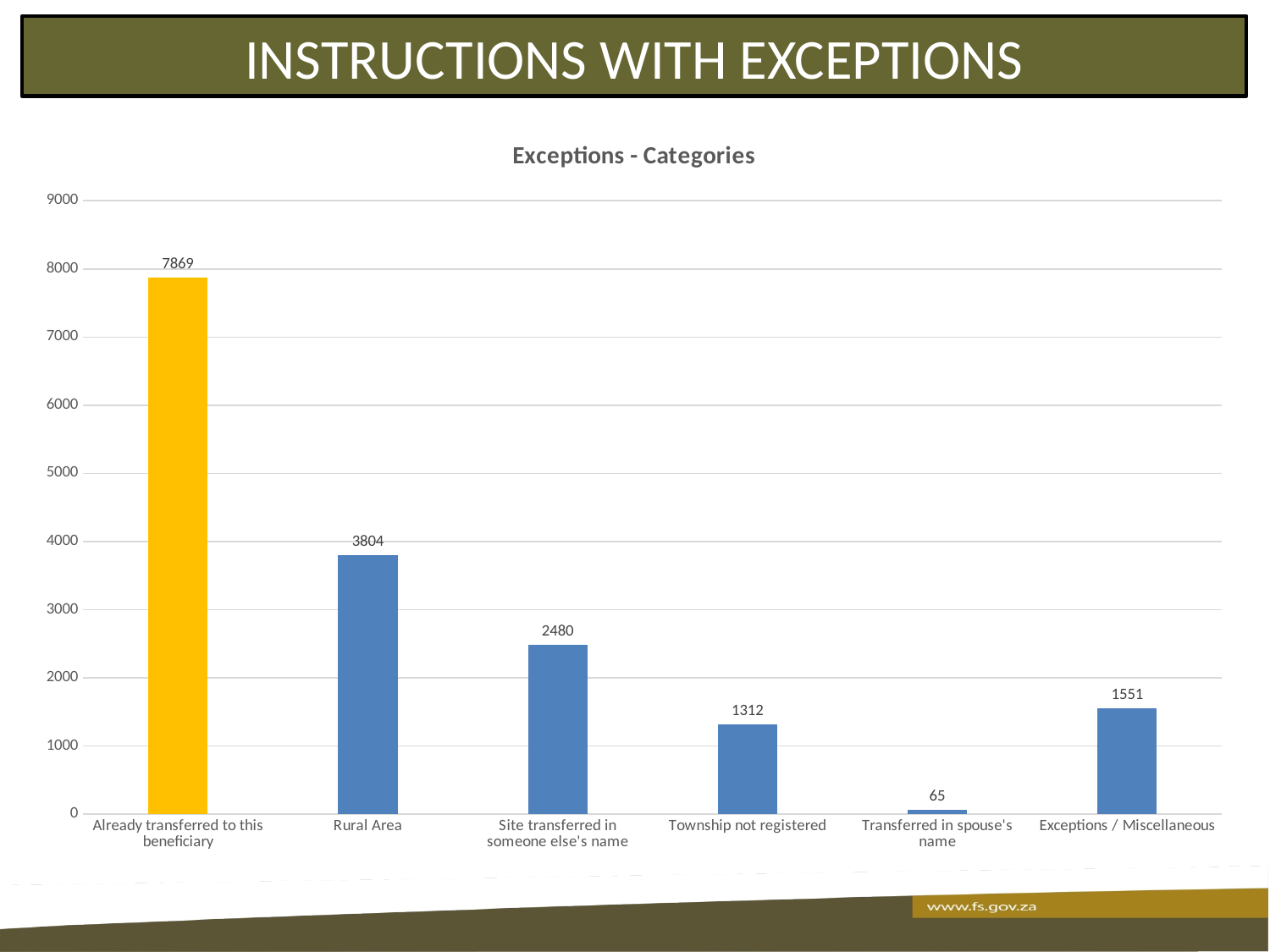
What is the value for Rural Area? 3804 Which category has the highest value? Already transferred to this beneficiary What kind of chart is shown on the slide? bar chart How many categories are shown in the chart? 6 What is the difference between the values for Already transferred to this beneficiary and Rural Area? 4065 Which category has the lowest value? Transferred in spouse's name What is the difference between the values for Site transferred in someone else's name and Exceptions / Miscellaneous? 929 What is the title of the chart? Exceptions - Categories Is the value for Site transferred in someone else's name greater or less than 2000? greater What is the value for Transferred in spouse's name? 65 What is the value for Township not registered? 1312 Which is larger, the value for Township not registered or the value for Exceptions / Miscellaneous? Exceptions / Miscellaneous